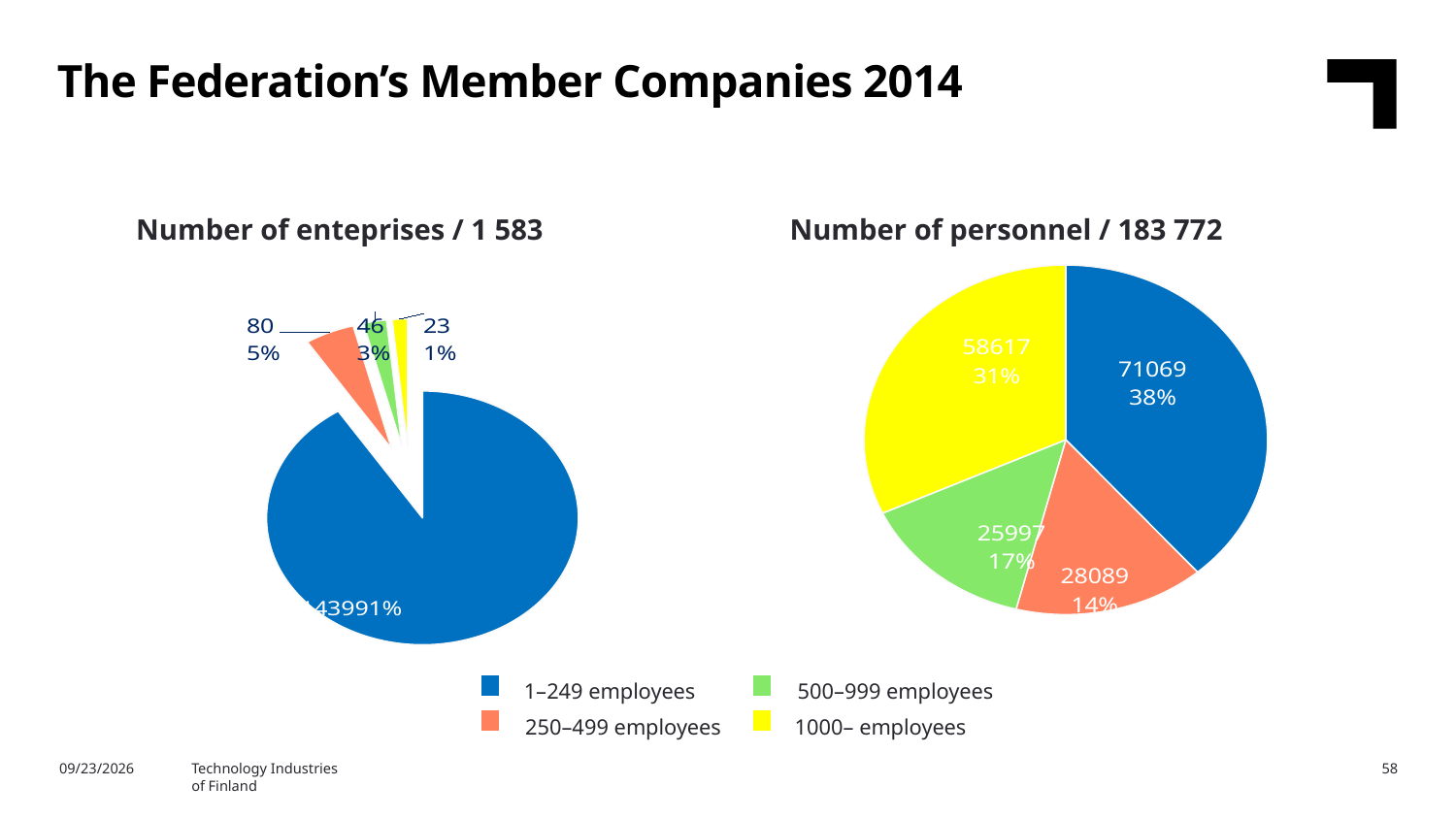
In the 'Number of enteprises / 1 583' chart, what share of the pie is the 500–999 employees slice? 3% In the 'Number of personnel / 183 772' chart, what share of the pie is the 1000– employees slice? 31% In the 'Number of personnel / 183 772' chart, which category has the largest slice? 1–249 employees How many categories does the legend list for the charts on this slide? 4 Which colour represents the 1000– employees category in the charts? yellow In the 'Number of personnel / 183 772' chart, what is the difference between the values for 1–249 employees and 1000– employees? 12452 In the 'Number of enteprises / 1 583' chart, what is the difference between the values for 250–499 employees and 500–999 employees? 34 In the 'Number of enteprises / 1 583' chart, which is larger: the value for 250–499 employees or the value for 1000– employees? 250–499 employees In the 'Number of personnel / 183 772' chart, what is the value for 1–249 employees? 71069 In the 'Number of enteprises / 1 583' chart, which category has the smallest slice? 1000– employees In the 'Number of enteprises / 1 583' chart, what is the value for 250–499 employees? 80 What kind of chart is the 'Number of personnel / 183 772' chart? pie chart